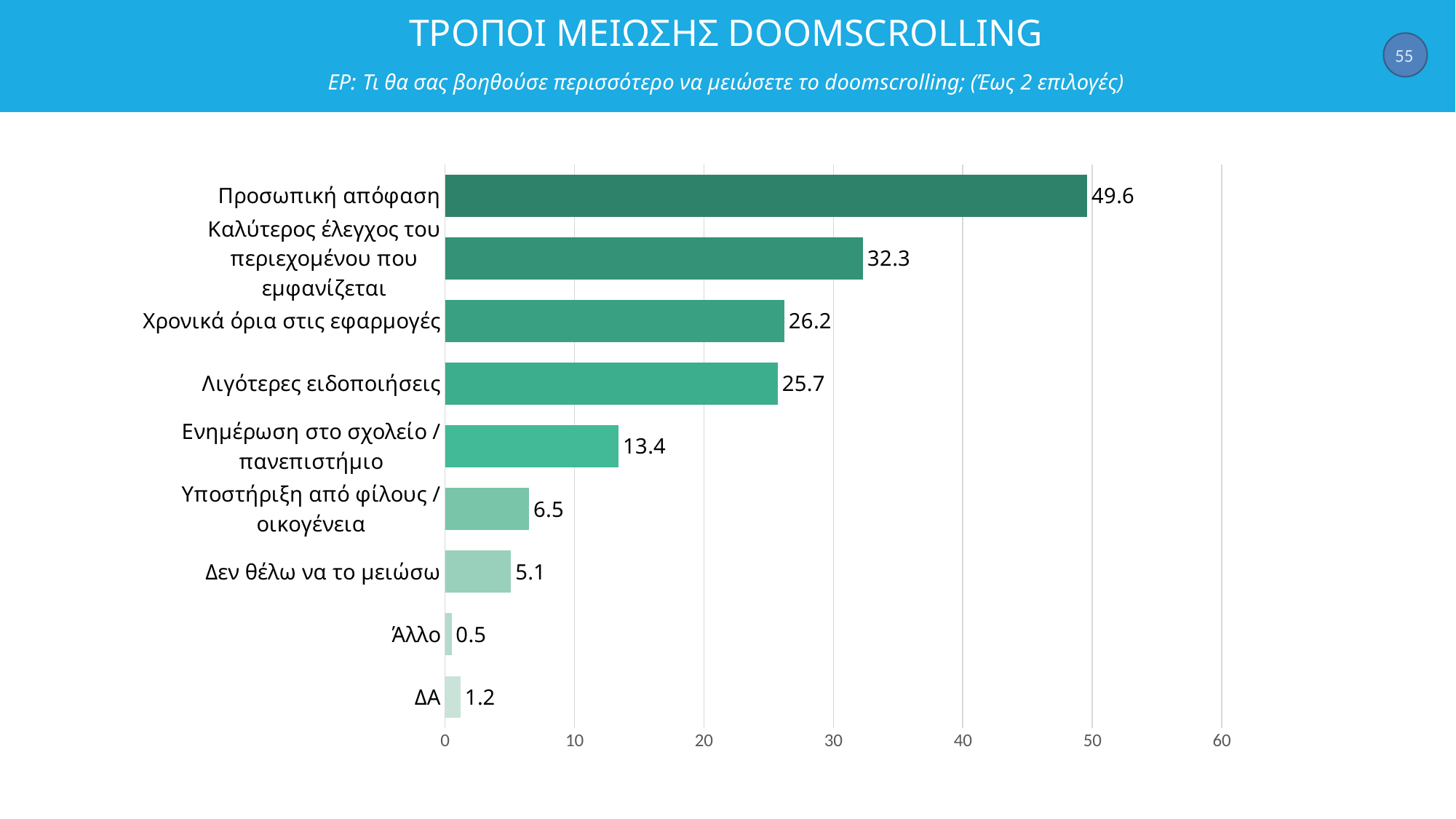
How many categories are shown in the chart? 9 What is the difference between the values for Προσωπική απόφαση and Καλύτερος έλεγχος του περιεχομένου που εμφανίζεται? 17.3 Which is larger, the value for Ενημέρωση στο σχολείο / πανεπιστήμιο or the value for Δεν θέλω να το μειώσω? Ενημέρωση στο σχολείο / πανεπιστήμιο What kind of chart is shown on the slide? bar chart What is the value for Χρονικά όρια στις εφαρμογές? 26.2 What is the value for ΔΑ? 1.2 What is the value for Προσωπική απόφαση? 49.6 Which category has the highest value? Προσωπική απόφαση Is the value for Λιγότερες ειδοποιήσεις greater or less than 20? greater What is the value for Υποστήριξη από φίλους / οικογένεια? 6.5 Which category has the lowest value? Άλλο What is the title of the slide? ΤΡΟΠΟΙ ΜΕΙΩΣΗΣ DOOMSCROLLING